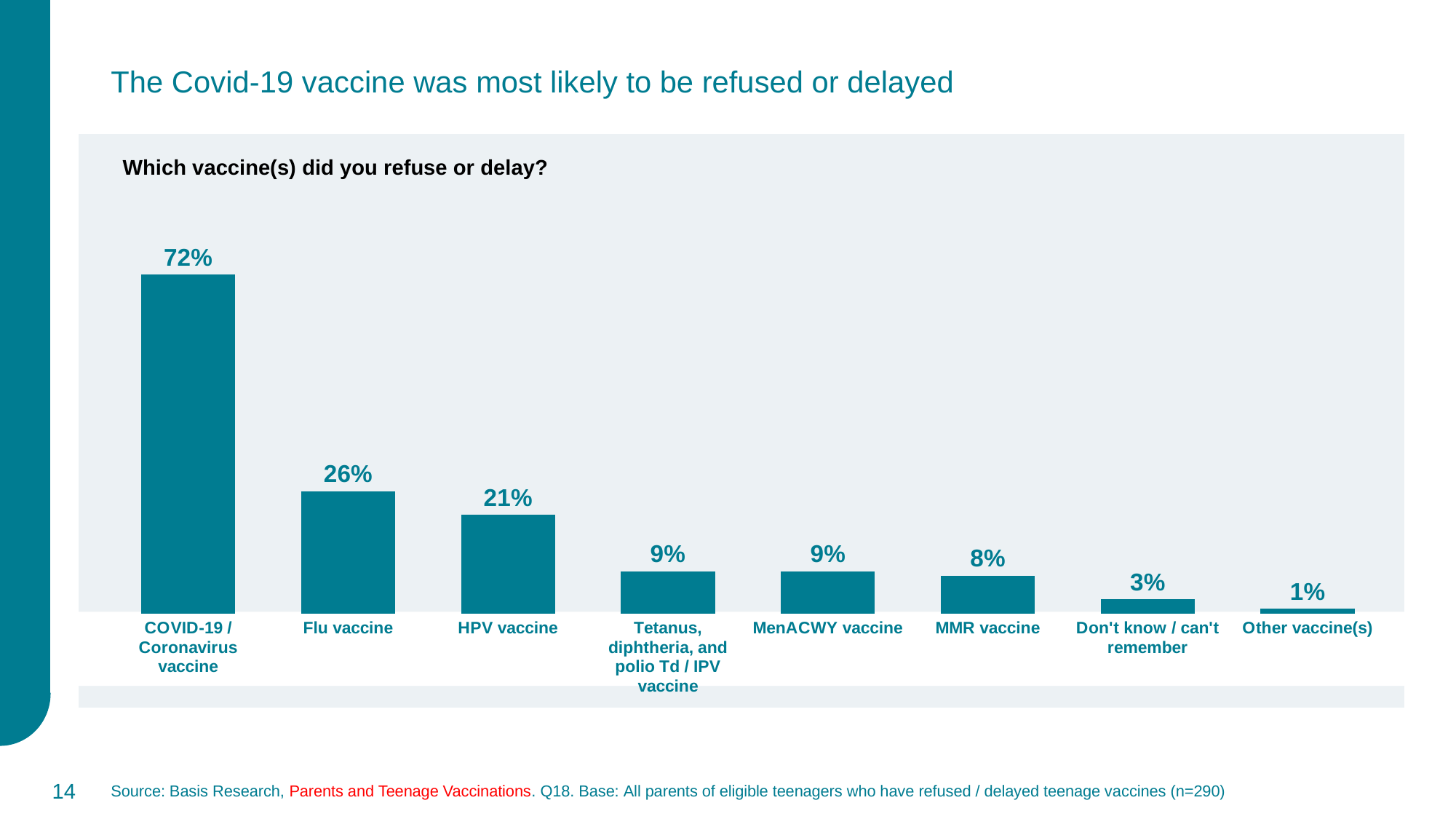
What is the value shown for the HPV vaccine? 21% Which is larger, the value for the Flu vaccine or the value for the HPV vaccine? Flu vaccine What kind of chart is shown on the slide? Bar chart What percentage of parents refused or delayed the COVID-19 / Coronavirus vaccine? 72% Which category has the lowest value on the chart? Other vaccine(s) What is the value shown for the Flu vaccine? 26% Which vaccine has the highest percentage of refusals or delays? COVID-19 / Coronavirus vaccine What is the value shown for 'Don't know / can't remember'? 3% What is the difference between the values for the COVID-19 / Coronavirus vaccine and the Flu vaccine? 46 percentage points How many categories are shown on the chart? 8 What is the value shown for the MMR vaccine? 8% What question is the chart titled with? Which vaccine(s) did you refuse or delay?